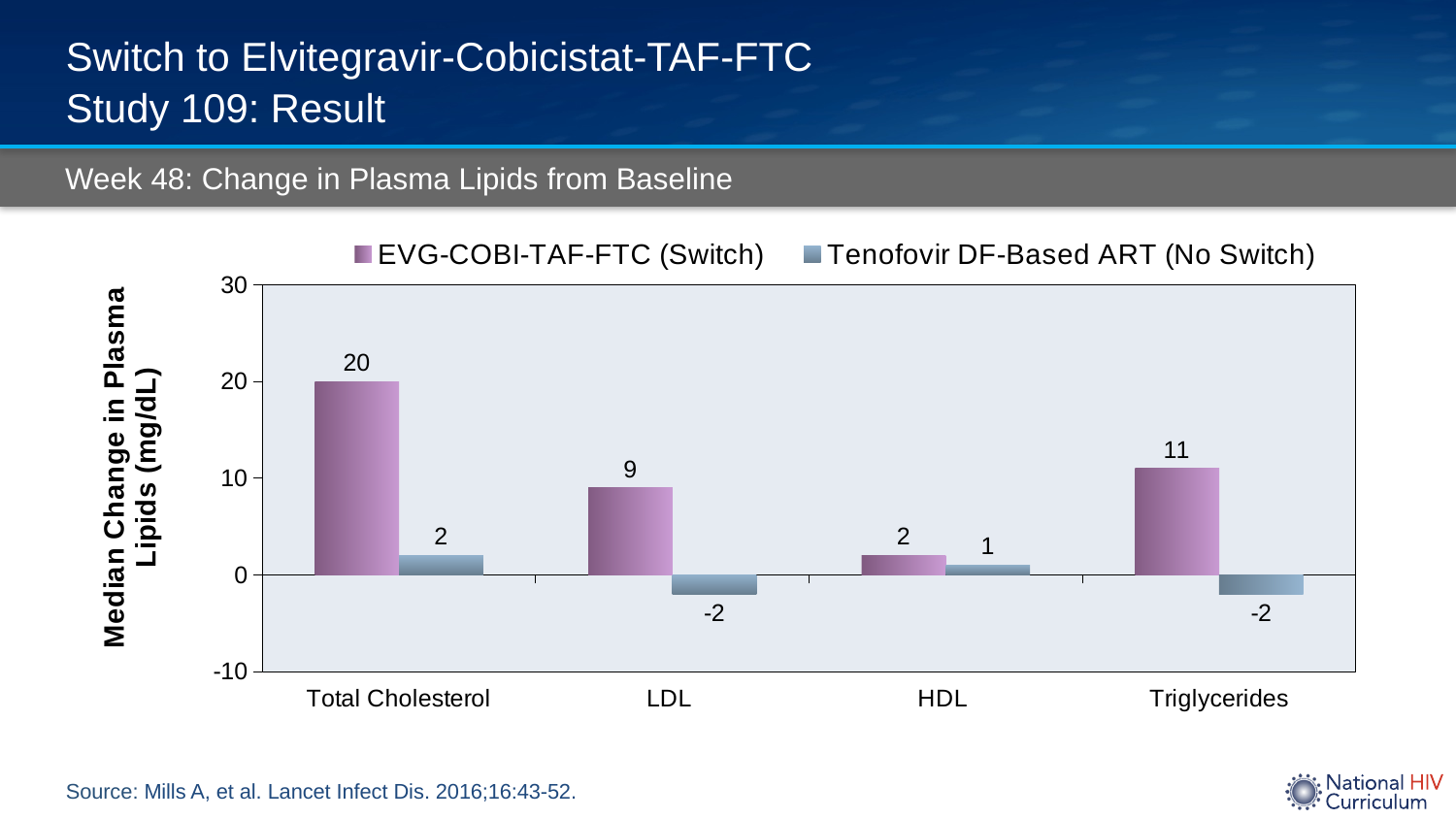
What kind of chart is shown on the slide? Bar chart Which lipid category has the highest value for the EVG-COBI-TAF-FTC (Switch) group? Total Cholesterol What is the median change in total cholesterol for the EVG-COBI-TAF-FTC (Switch) group? 20 What is the difference between the Switch and No Switch values for triglycerides? 13 What is the median change in triglycerides for the EVG-COBI-TAF-FTC (Switch) group? 11 How many lipid categories are shown on the x axis? 4 Which group has the larger median change in LDL, EVG-COBI-TAF-FTC (Switch) or Tenofovir DF-Based ART (No Switch)? EVG-COBI-TAF-FTC (Switch) Which lipid category has the lowest value for the EVG-COBI-TAF-FTC (Switch) group? HDL What is the median change in HDL for the Tenofovir DF-Based ART (No Switch) group? 1 What is the difference between the Switch and No Switch values for total cholesterol? 18 How many series does the legend list? 2 What is the median change in LDL for the Tenofovir DF-Based ART (No Switch) group? -2